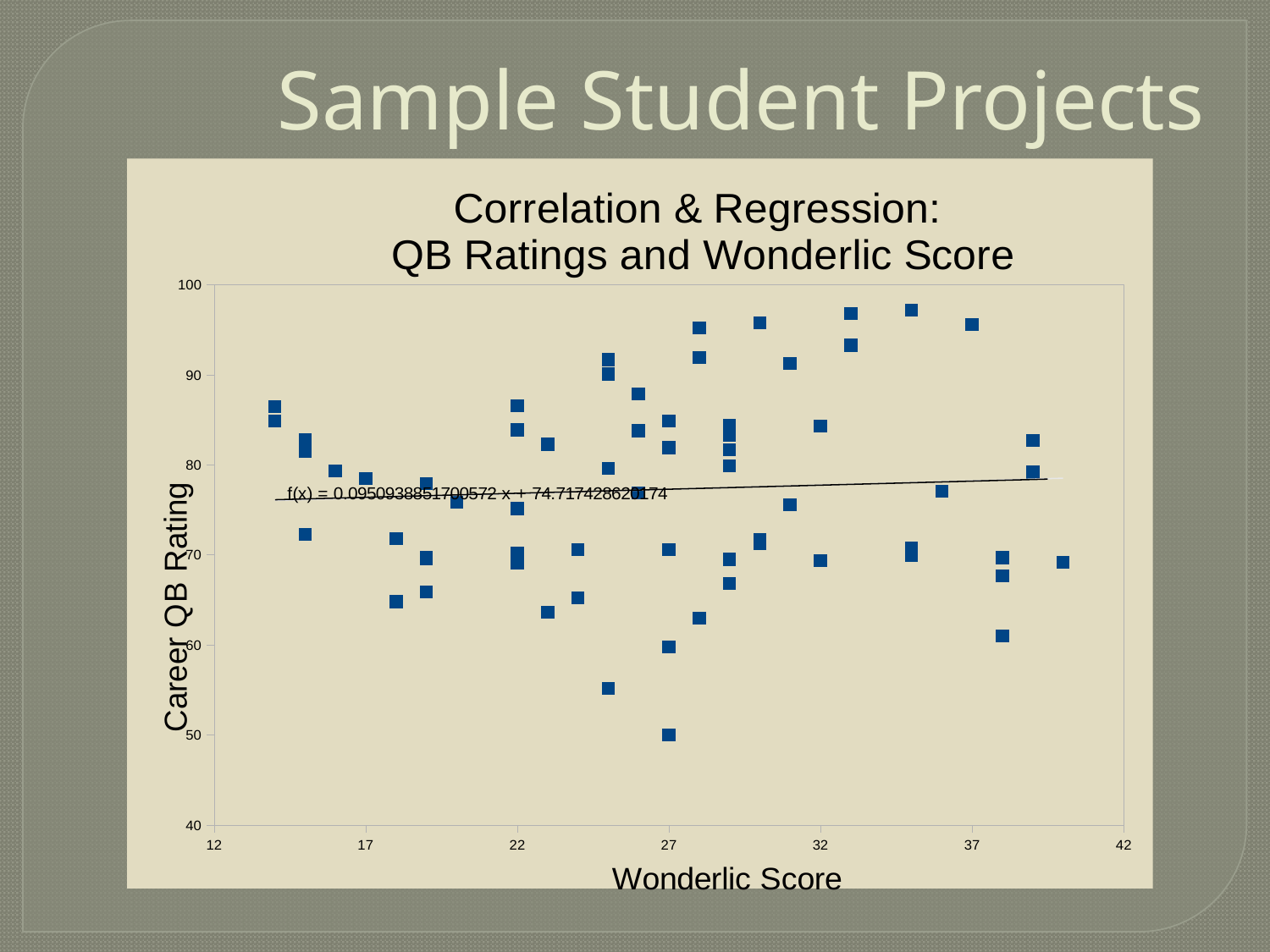
What is the maximum value shown on the x axis? 42 What is the title of the chart? Correlation & Regression: QB Ratings and Wonderlic Score What is the minimum value shown on the x axis? 12 What kind of chart is shown on the slide? Scatter plot Is the highest Career QB Rating plotted greater or less than 90? greater What is the label of the y axis? Career QB Rating What is the maximum value shown on the y axis? 100 Does the fitted regression line rise or fall as Wonderlic Score increases? Rises Is the slope of the fitted line f(x) positive or negative? Positive Is the lowest Career QB Rating plotted greater or less than 60? less Is the intercept of the fitted line f(x) greater or less than 70? greater What is the label of the x axis? Wonderlic Score